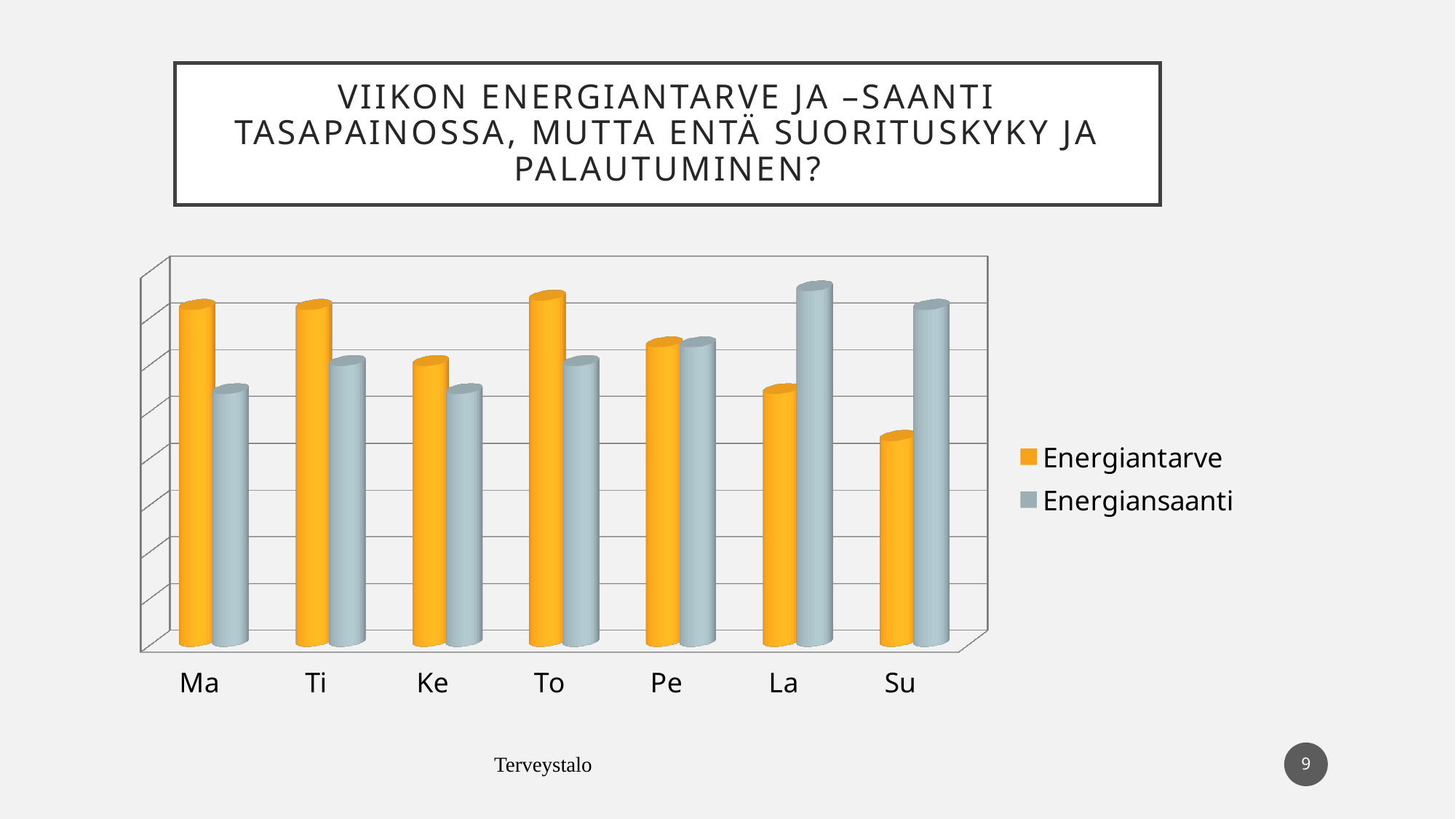
Which day has the highest Energiansaanti value? La On Ma, which is larger: Energiantarve or Energiansaanti? Energiantarve Which day has the lowest Energiantarve value? Su On Ti, which is larger: Energiantarve or Energiansaanti? Energiantarve How many series does the chart's legend list? 2 On Su, which is larger: Energiantarve or Energiansaanti? Energiansaanti What are the two series names listed in the chart's legend? Energiantarve and Energiansaanti Which day has the highest Energiantarve value? To What kind of chart is shown on the slide? bar chart Which series is shown in orange in the chart? Energiantarve How many categories (days) are shown on the x axis of the chart? 7